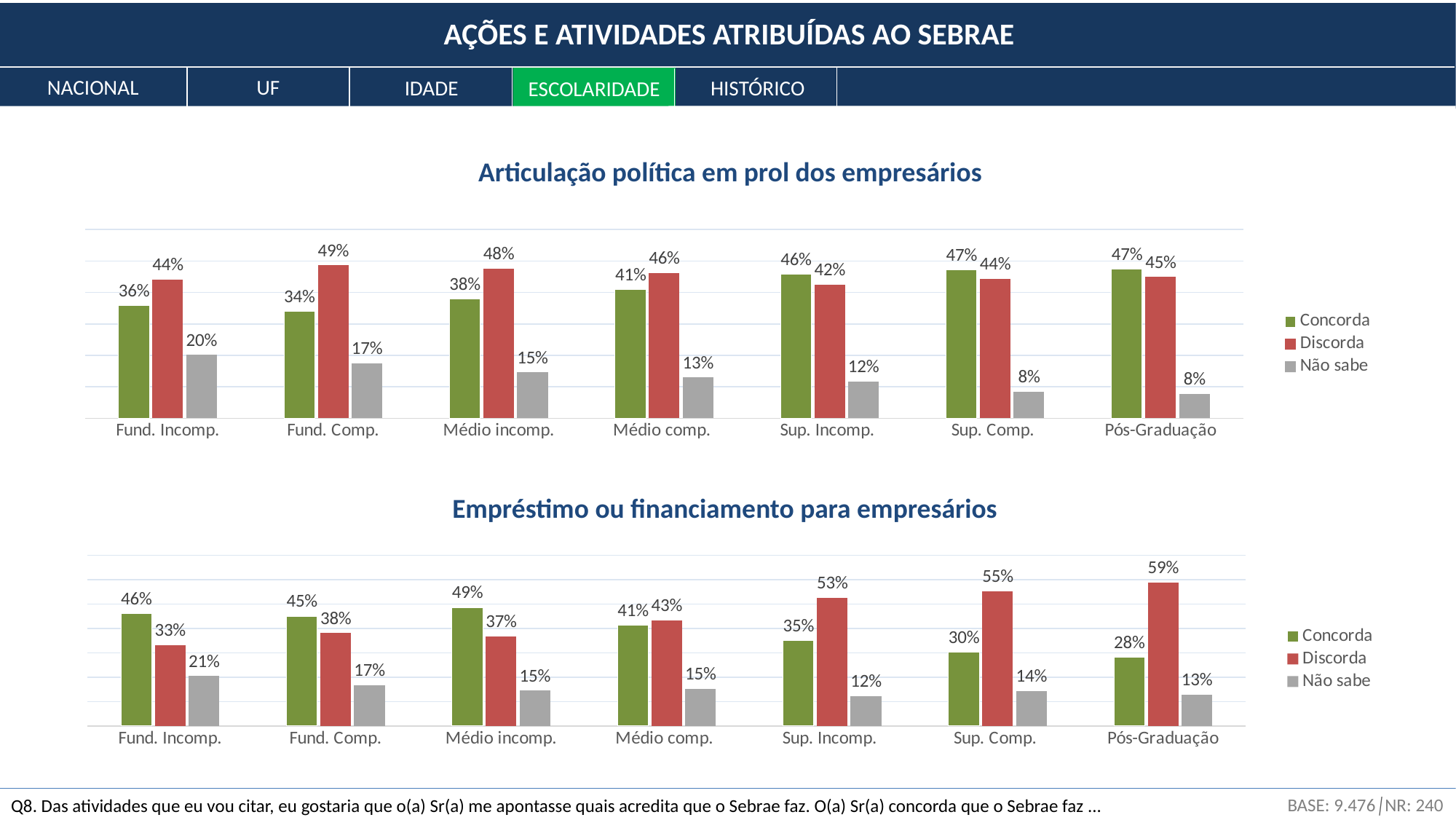
In the 'Empréstimo ou financiamento para empresários' chart, how does the Discorda value change from Fund. Incomp. to Pós-Graduação? It rises In the 'Articulação política em prol dos empresários' chart, what is the Não sabe value for Fund. Incomp.? 20% In the 'Articulação política em prol dos empresários' chart, what is the Concorda value for Fund. Comp.? 34% How many series does the legend of the 'Empréstimo ou financiamento para empresários' chart list? 3 In the 'Articulação política em prol dos empresários' chart, which category has the highest Discorda value? Fund. Comp. What type of chart is the 'Articulação política em prol dos empresários' chart? Bar chart In the 'Empréstimo ou financiamento para empresários' chart, what is the difference between the Concorda and Discorda values for Fund. Incomp.? 13% In the 'Empréstimo ou financiamento para empresários' chart, what is the Discorda value for Pós-Graduação? 59% In the 'Empréstimo ou financiamento para empresários' chart, which is larger for Sup. Incomp.: Concorda or Discorda? Discorda In the 'Articulação política em prol dos empresários' chart, what is the difference between the Discorda and Concorda values for Fund. Comp.? 15% In the 'Articulação política em prol dos empresários' chart, how many categories are shown on the x axis? 7 In the 'Empréstimo ou financiamento para empresários' chart, which category has the lowest Concorda value? Pós-Graduação